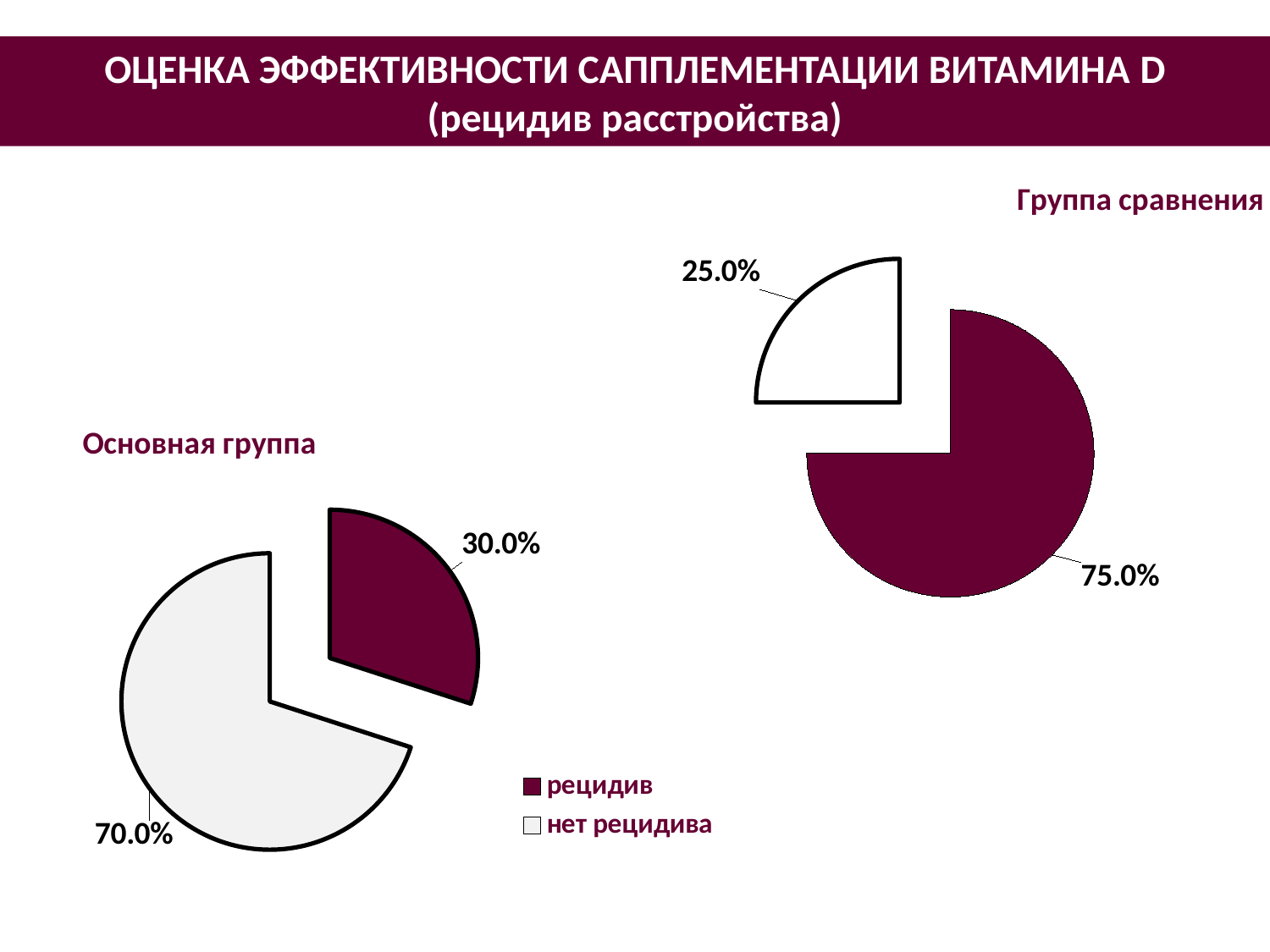
What type of chart is used for "Основная группа"? Pie chart In the "Основная группа" chart, what share is labelled for the "рецидив" slice? 30.0% In the "Группа сравнения" chart, what share is labelled for the "нет рецидива" slice? 25.0% Which chart has the larger "рецидив" share, "Основная группа" or "Группа сравнения"? Группа сравнения How many entries does the legend list? 2 Which legend entry is shown in the dark maroon colour? рецидив What is the difference between the "рецидив" share in the "Группа сравнения" chart and the "рецидив" share in the "Основная группа" chart? 45.0% In the "Основная группа" chart, what share is labelled for the "нет рецидива" slice? 70.0% How many slices does the "Группа сравнения" chart have? 2 In the "Основная группа" chart, which slice is the largest? нет рецидива In the "Группа сравнения" chart, which slice is the smallest? нет рецидива In the "Группа сравнения" chart, what share is labelled for the "рецидив" slice? 75.0%